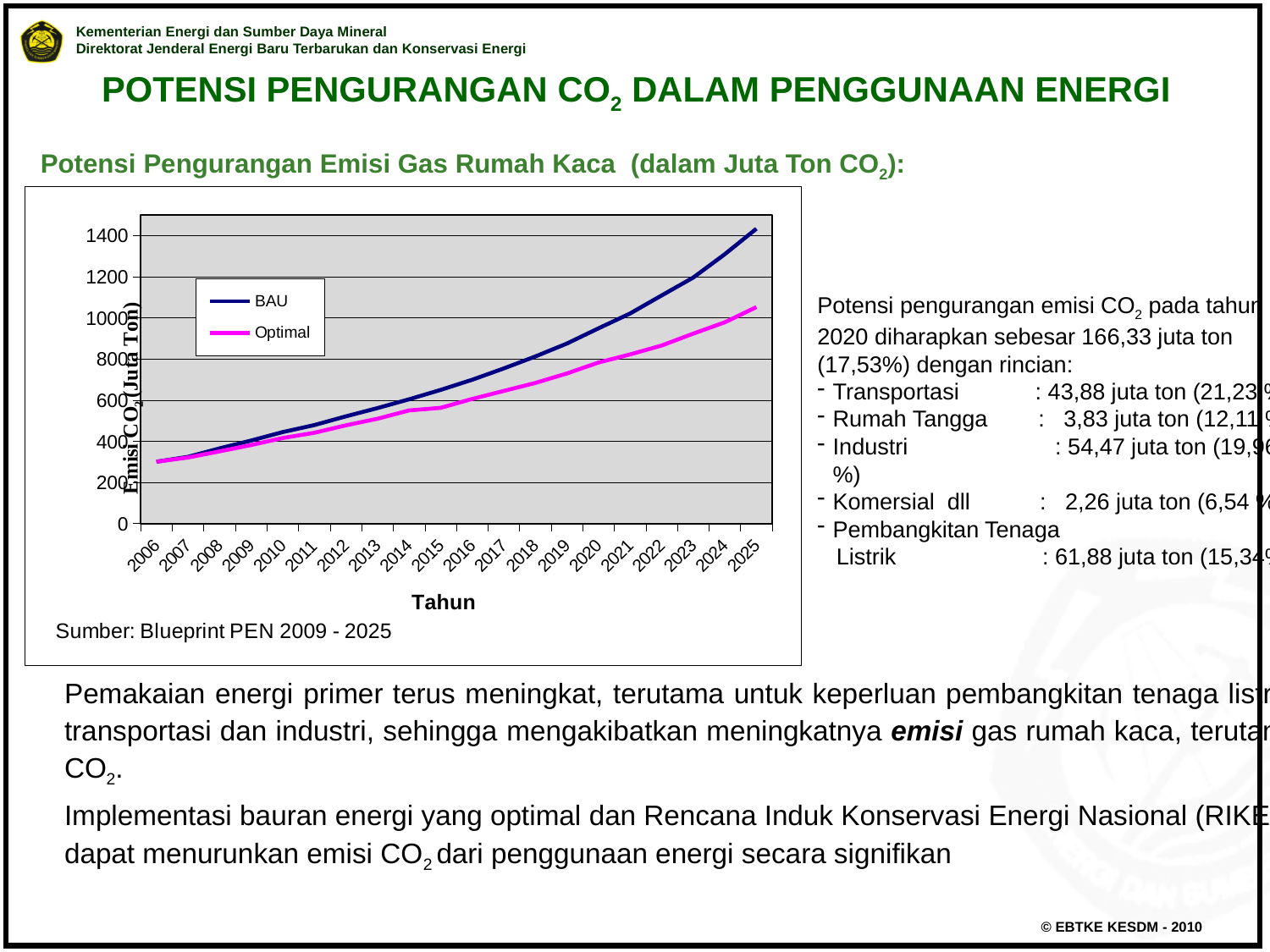
What is the title of the x axis of the chart? Tahun Which series is drawn in magenta (pink) in the chart? Optimal What kind of chart is shown on the slide? line chart Is the BAU value for 2006 greater or less than 400? less Do the BAU values rise or fall from 2006 to 2025? rise Is the BAU value for 2020 greater or less than 800? greater How many series does the chart legend list? 2 Is the Optimal value for 2015 greater or less than 600? less In 2025, which series has the larger value, BAU or Optimal? BAU How many years are plotted along the x axis of the chart? 20